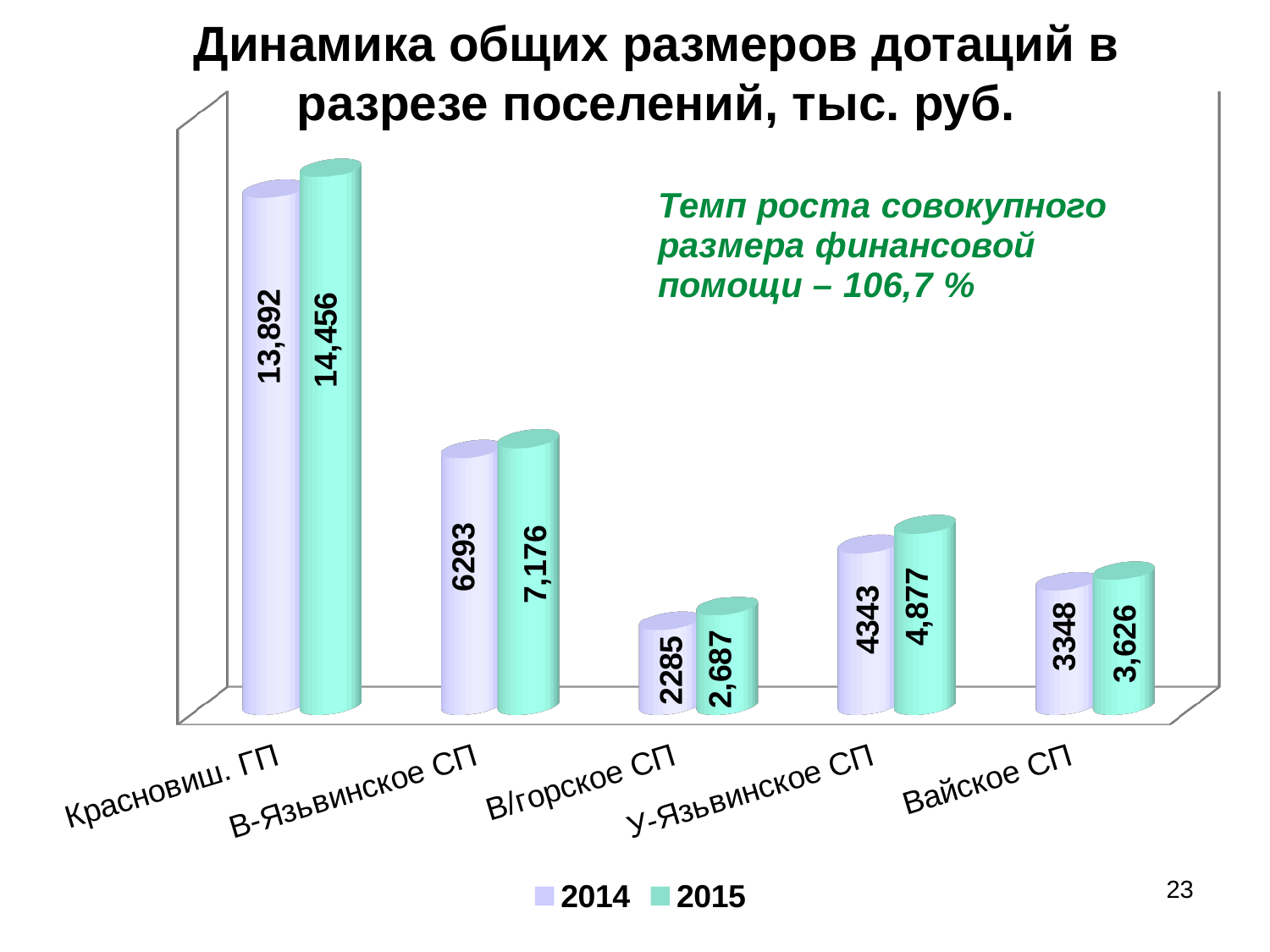
What is the 2014 value for Красновиш. ГП? 13,892 What is the 2014 value for В/горское СП? 2285 What is the difference between the 2015 and 2014 values for Красновиш. ГП? 564 Which settlement has the lowest 2014 value? В/горское СП Which is larger: the 2014 value for У-Язьвинское СП or the 2014 value for Вайское СП? У-Язьвинское СП Which settlement has the highest 2015 value? Красновиш. ГП How many series does the legend list? 2 What is the 2015 value for В-Язьвинское СП? 7,176 How many settlements are shown on the x axis? 5 What is the difference between the 2015 and 2014 values for У-Язьвинское СП? 534 What kind of chart is shown on the slide? Bar chart What is the 2015 value for Вайское СП? 3,626